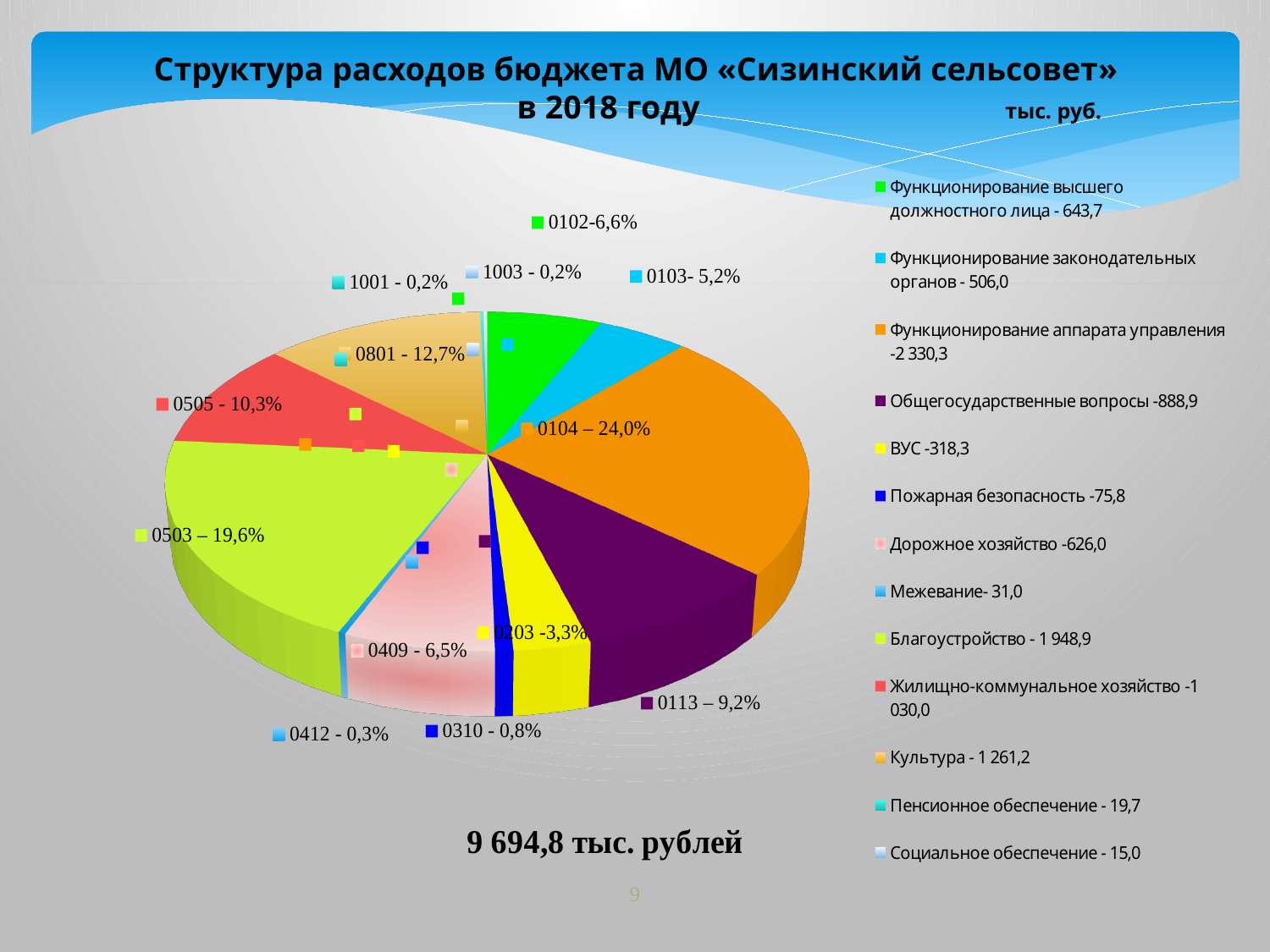
What is the difference in percentage points between the 0104 slice and the 0503 slice? 4,4 What value does the legend give for Пожарная безопасность? 75,8 Which slice is larger, 0505 or 0113? 0505 How many entries does the legend list? 13 What share of the pie does the slice labelled 0801 have? 12,7% What kind of chart is shown on the slide? pie chart Which slice has the largest share of the pie? 0104 What share of the pie does the slice labelled 0503 have? 19,6% What total amount is printed below the pie chart? 9 694,8 тыс. рублей What value does the legend give for Благоустройство? 1 948,9 What value does the legend give for Функционирование аппарата управления? 2 330,3 What share of the pie does the slice labelled 0104 have? 24,0%